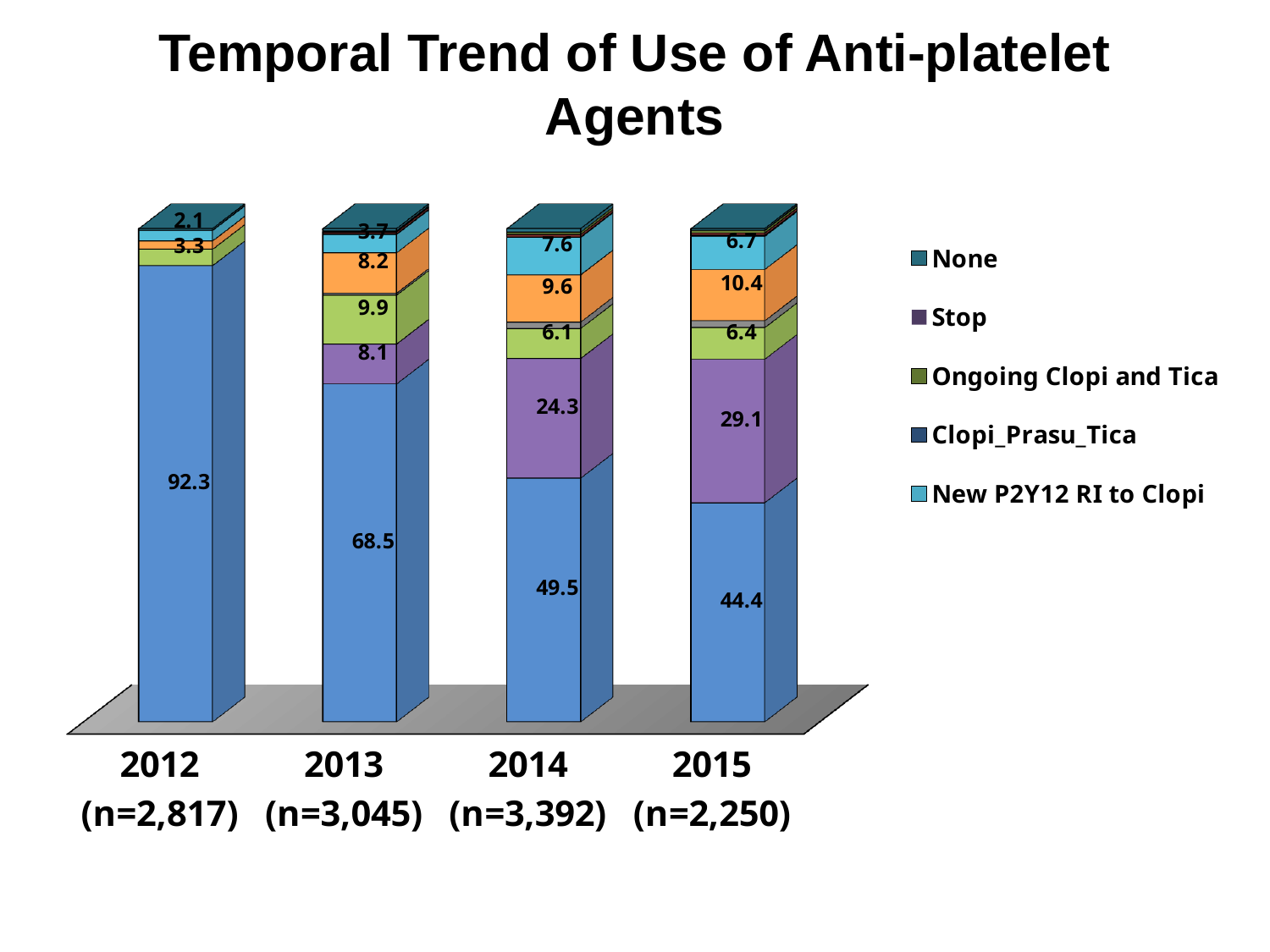
What is the value of the New P2Y12 RI to Clopi segment for 2014? 7.6 How many years (bars) are shown on the x axis? 4 How many series does the legend list? 5 Does the value of the bottom (blue) segment rise or fall from 2012 to 2015? fall What is the value labelled on the bottom (blue) segment of the 2012 bar? 92.3 What kind of chart is shown on the slide? stacked bar chart